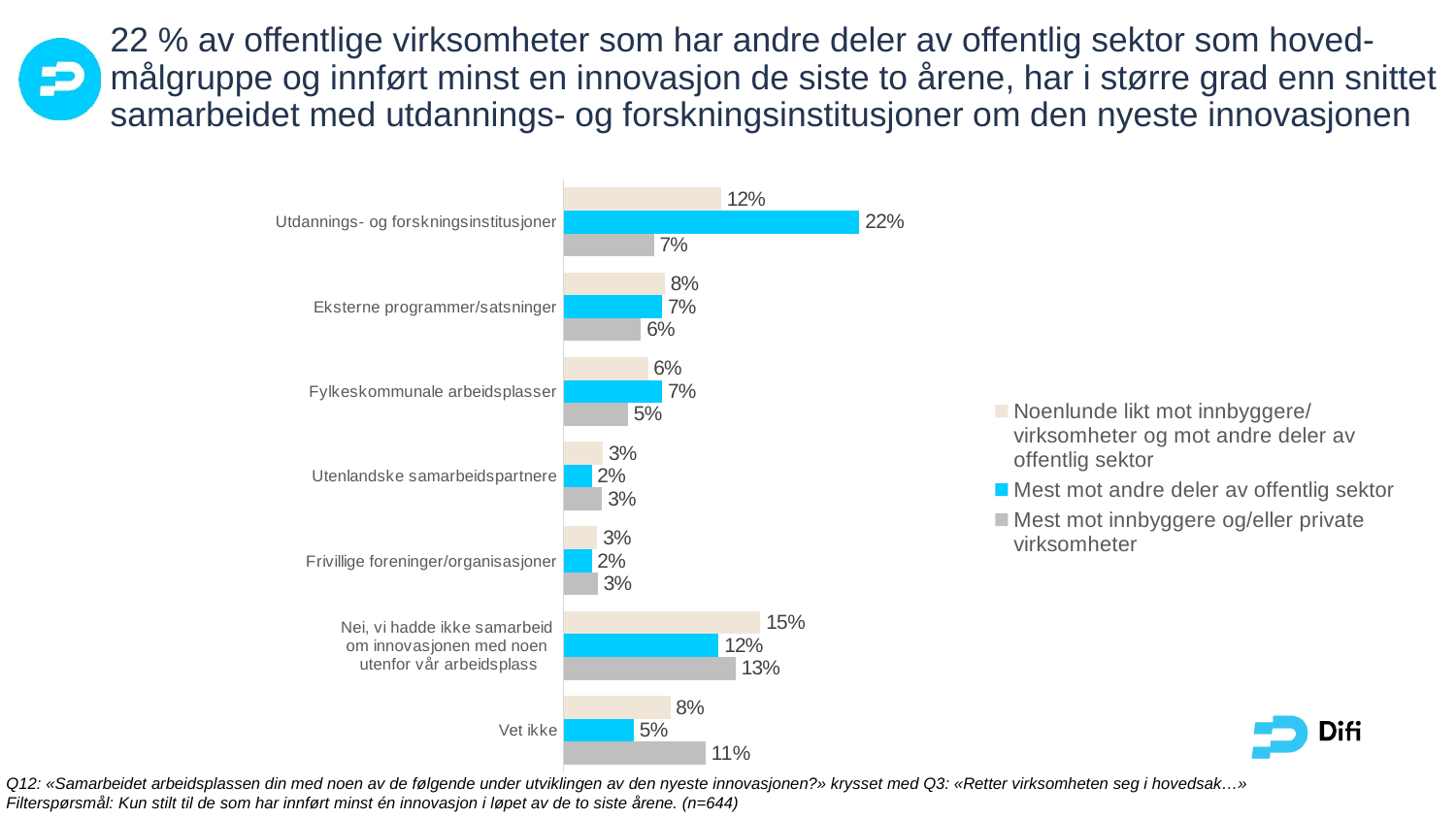
For "Vet ikke", which is larger: the value for "Mest mot andre deler av offentlig sektor" or the value for "Mest mot innbyggere og/eller private virksomheter"? Mest mot innbyggere og/eller private virksomheter Which colour represents the series "Mest mot andre deler av offentlig sektor" in the legend? Blue What kind of chart is shown on the slide? Bar chart How many categories are shown on the chart? 7 What is the value for "Mest mot andre deler av offentlig sektor" in the category "Utdannings- og forskningsinstitusjoner"? 22% What is the value for "Mest mot innbyggere og/eller private virksomheter" in the category "Vet ikke"? 11% What is the value for "Mest mot andre deler av offentlig sektor" in the category "Fylkeskommunale arbeidsplasser"? 7% How many series does the legend list? 3 What is the difference between the "Mest mot andre deler av offentlig sektor" value and the "Mest mot innbyggere og/eller private virksomheter" value for "Utdannings- og forskningsinstitusjoner"? 15 percentage points Which category has the highest value for the series "Mest mot andre deler av offentlig sektor"? Utdannings- og forskningsinstitusjoner What is the value for "Noenlunde likt mot innbyggere/virksomheter og mot andre deler av offentlig sektor" in the category "Nei, vi hadde ikke samarbeid om innovasjonen med noen utenfor vår arbeidsplass"? 15% Which category has the lowest value for the series "Noenlunde likt mot innbyggere/virksomheter og mot andre deler av offentlig sektor"? Utenlandske samarbeidspartnere and Frivillige foreninger/organisasjoner (both 3%)